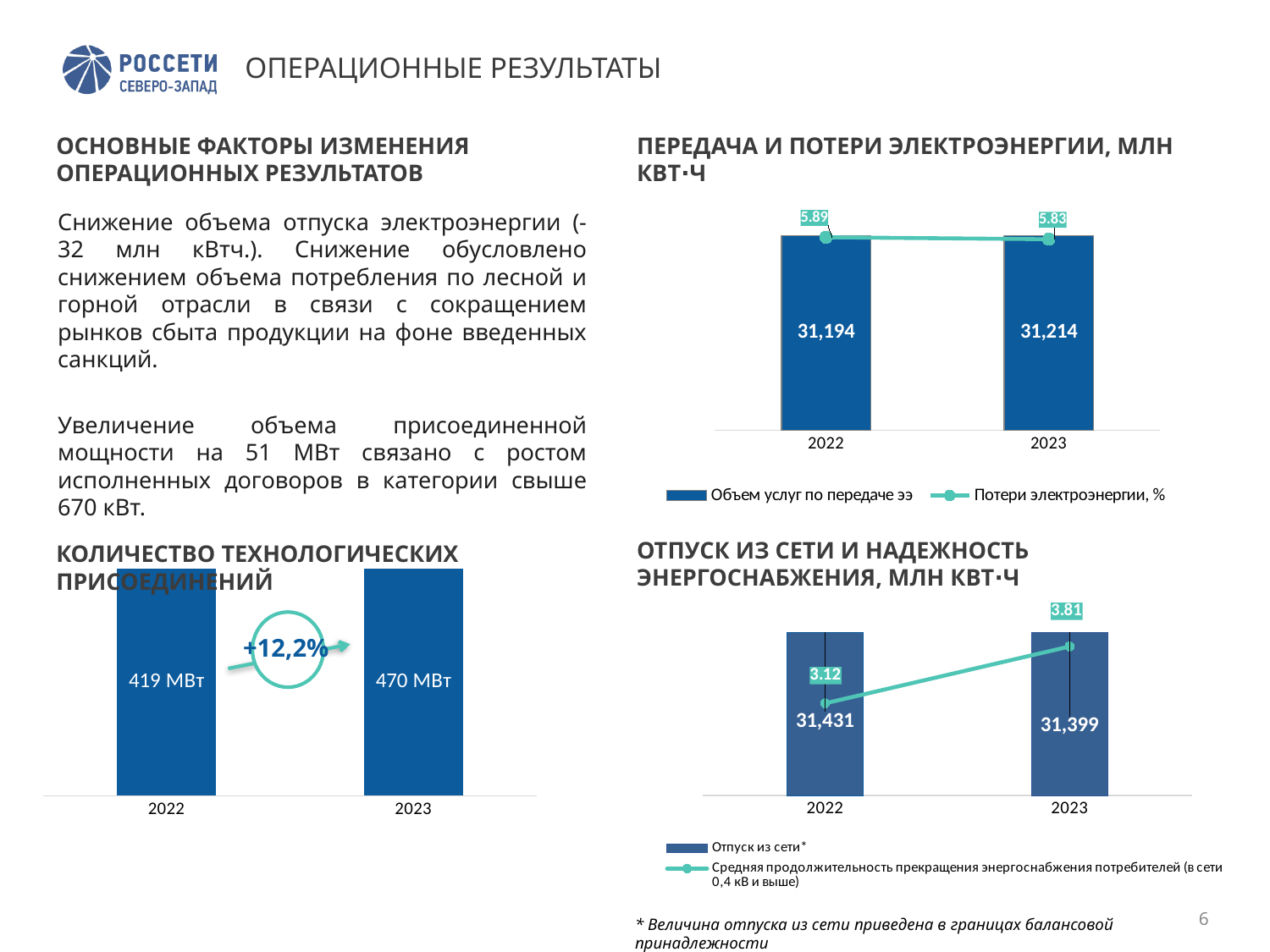
In the chart 'ПЕРЕДАЧА И ПОТЕРИ ЭЛЕКТРОЭНЕРГИИ, МЛН КВТ·Ч', by how much did 'Объем услуг по передаче ээ' change from 2022 to 2023? 20 In the chart 'ПЕРЕДАЧА И ПОТЕРИ ЭЛЕКТРОЭНЕРГИИ, МЛН КВТ·Ч', what is the value of 'Потери электроэнергии, %' for 2022? 5.89 In the chart 'ОТПУСК ИЗ СЕТИ И НАДЕЖНОСТЬ ЭНЕРГОСНАБЖЕНИЯ, МЛН КВТ·Ч', which year has the lower value of 'Отпуск из сети*'? 2023 In the chart 'ОТПУСК ИЗ СЕТИ И НАДЕЖНОСТЬ ЭНЕРГОСНАБЖЕНИЯ, МЛН КВТ·Ч', what is the value of the line series for 2023? 3.81 In the chart 'ОТПУСК ИЗ СЕТИ И НАДЕЖНОСТЬ ЭНЕРГОСНАБЖЕНИЯ, МЛН КВТ·Ч', what is the value of 'Отпуск из сети*' for 2022? 31,431 In the chart 'КОЛИЧЕСТВО ТЕХНОЛОГИЧЕСКИХ ПРИСОЕДИНЕНИЙ', what percentage change is shown between 2022 and 2023? +12,2% In the chart 'ПЕРЕДАЧА И ПОТЕРИ ЭЛЕКТРОЭНЕРГИИ, МЛН КВТ·Ч', does 'Потери электроэнергии, %' rise or fall from 2022 to 2023? fall In the chart 'КОЛИЧЕСТВО ТЕХНОЛОГИЧЕСКИХ ПРИСОЕДИНЕНИЙ', which year has the higher value? 2023 In the chart 'ПЕРЕДАЧА И ПОТЕРИ ЭЛЕКТРОЭНЕРГИИ, МЛН КВТ·Ч', what is the value of 'Объем услуг по передаче ээ' for 2023? 31,214 What kind of chart is 'КОЛИЧЕСТВО ТЕХНОЛОГИЧЕСКИХ ПРИСОЕДИНЕНИЙ'? bar chart How many series does the legend of the chart 'ПЕРЕДАЧА И ПОТЕРИ ЭЛЕКТРОЭНЕРГИИ, МЛН КВТ·Ч' list? 2 In the chart 'КОЛИЧЕСТВО ТЕХНОЛОГИЧЕСКИХ ПРИСОЕДИНЕНИЙ', what is the value for 2022? 419 МВт